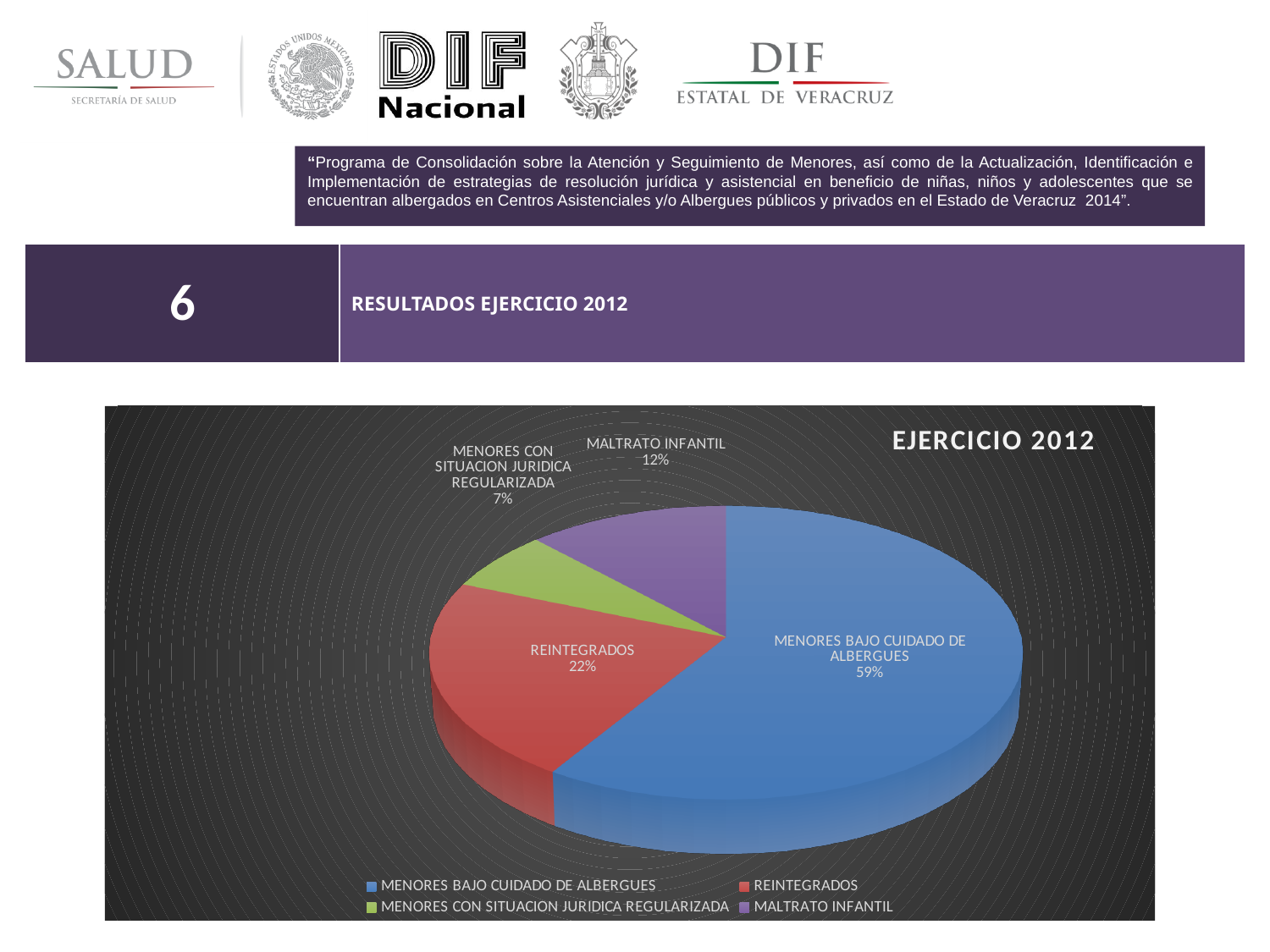
Which is larger, the share for REINTEGRADOS or the share for MALTRATO INFANTIL? REINTEGRADOS What share of the pie does MENORES CON SITUACION JURIDICA REGULARIZADA represent? 7% What share of the pie does MENORES BAJO CUIDADO DE ALBERGUES represent? 59% What is the title of the chart? EJERCICIO 2012 What kind of chart is shown on the slide? Pie chart What share of the pie does REINTEGRADOS represent? 22% How many categories are shown in the pie chart? 4 Which category has the largest slice of the pie? MENORES BAJO CUIDADO DE ALBERGUES What is the difference in percentage points between MENORES BAJO CUIDADO DE ALBERGUES and REINTEGRADOS? 37 Which category has the smallest slice of the pie? MENORES CON SITUACION JURIDICA REGULARIZADA What colour is the slice for REINTEGRADOS? Red